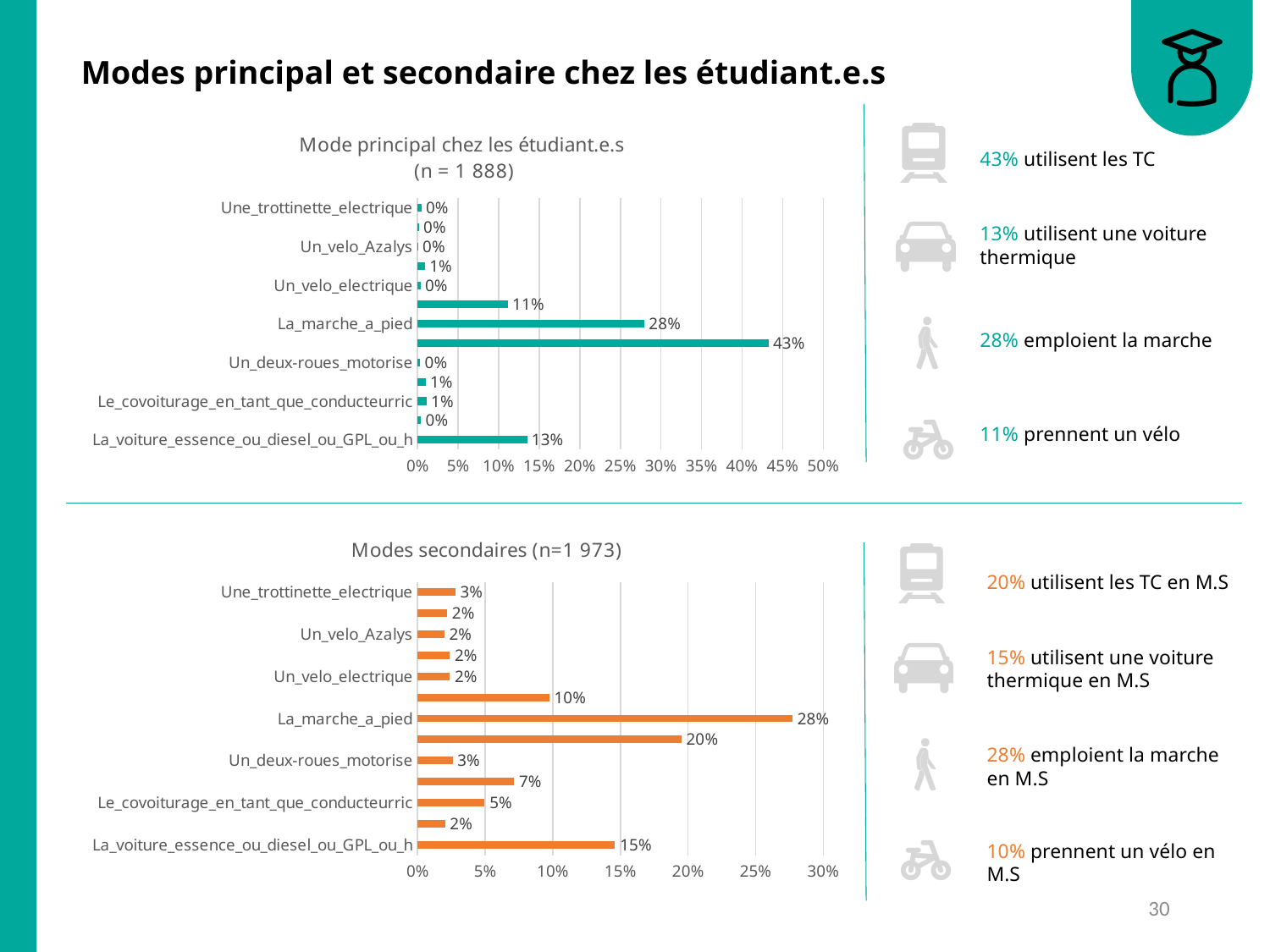
In the chart 'Modes secondaires', what is the value for La_marche_a_pied? 28% In the chart 'Mode principal chez les étudiant.e.s', what is the highest value shown on any bar? 43% In the chart 'Modes secondaires', what is the difference between La_marche_a_pied and La_voiture_essence_ou_diesel_ou_GPL_ou_h? 13% In the chart 'Modes secondaires', what is the value for Le_covoiturage_en_tant_que_conducteurric? 5% What sample size (n) is given in the title of the bottom chart 'Modes secondaires'? 1 973 In the chart 'Mode principal chez les étudiant.e.s', what is the value for La_marche_a_pied? 28% In the chart 'Modes secondaires', what is the value for Une_trottinette_electrique? 3% In the chart 'Modes secondaires', which is larger: La_voiture_essence_ou_diesel_ou_GPL_ou_h or Un_deux-roues_motorise? La_voiture_essence_ou_diesel_ou_GPL_ou_h In the chart 'Modes secondaires', which labeled category has the highest value? La_marche_a_pied What kind of chart is the top chart 'Mode principal chez les étudiant.e.s'? Bar chart In the chart 'Mode principal chez les étudiant.e.s', what is the difference between La_marche_a_pied and La_voiture_essence_ou_diesel_ou_GPL_ou_h? 15% In the chart 'Mode principal chez les étudiant.e.s', what is the value for La_voiture_essence_ou_diesel_ou_GPL_ou_h? 13%